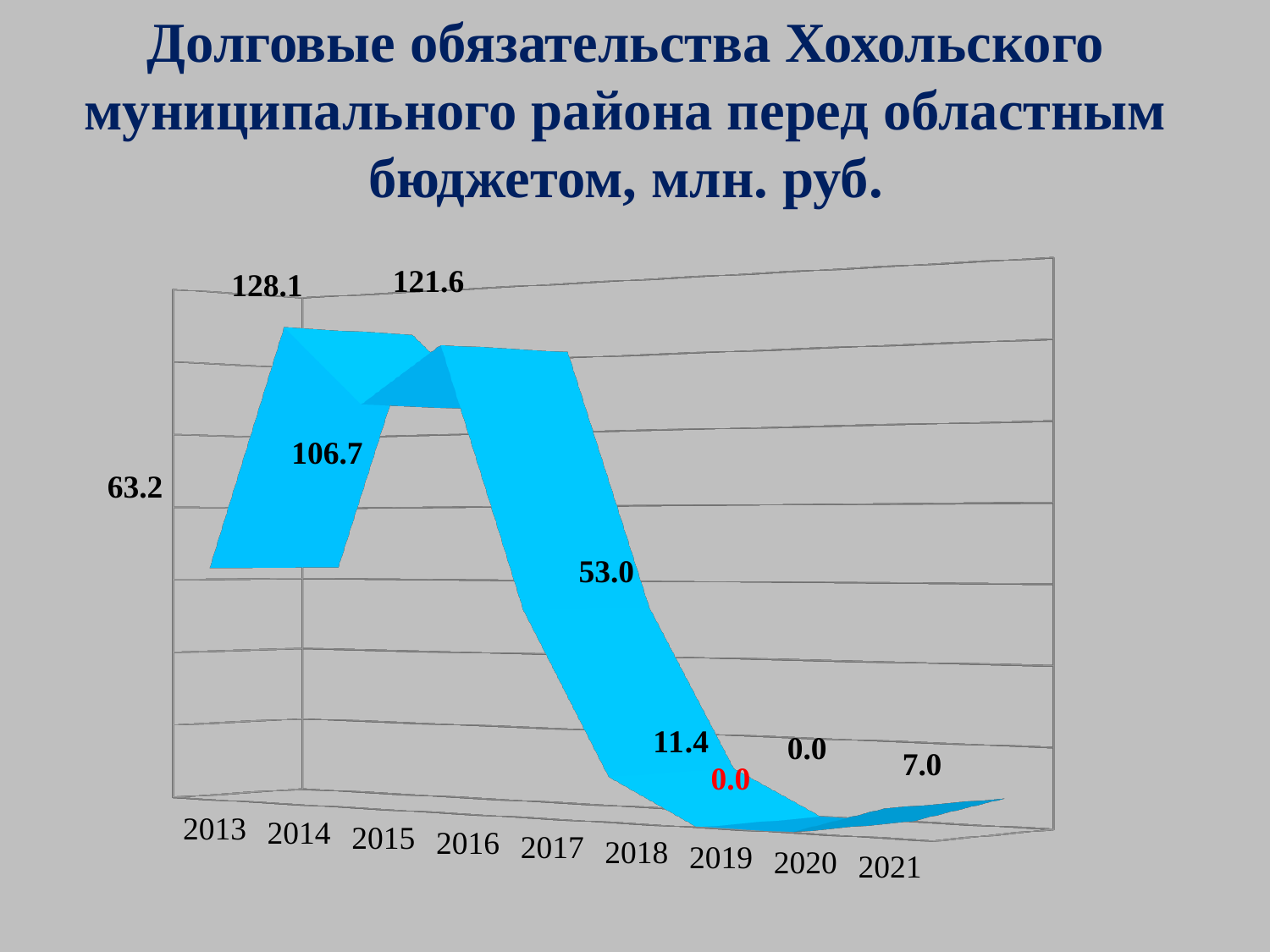
Which is larger, the value for 2015 or the value for 2016? 2016 What is the value for 2014? 128.1 How many years are shown on the x axis? 9 What is the difference between the values for 2017 and 2018? 41.6 What kind of chart is this? 3D line chart What is the value for 2021? 7.0 What is the value for 2013? 63.2 Which year has the highest value? 2014 What is the difference between the values for 2014 and 2013? 64.9 What is the value for 2017? 53.0 What is the lowest value shown on the chart? 0.0 Do the values rise or fall from 2016 to 2019? fall